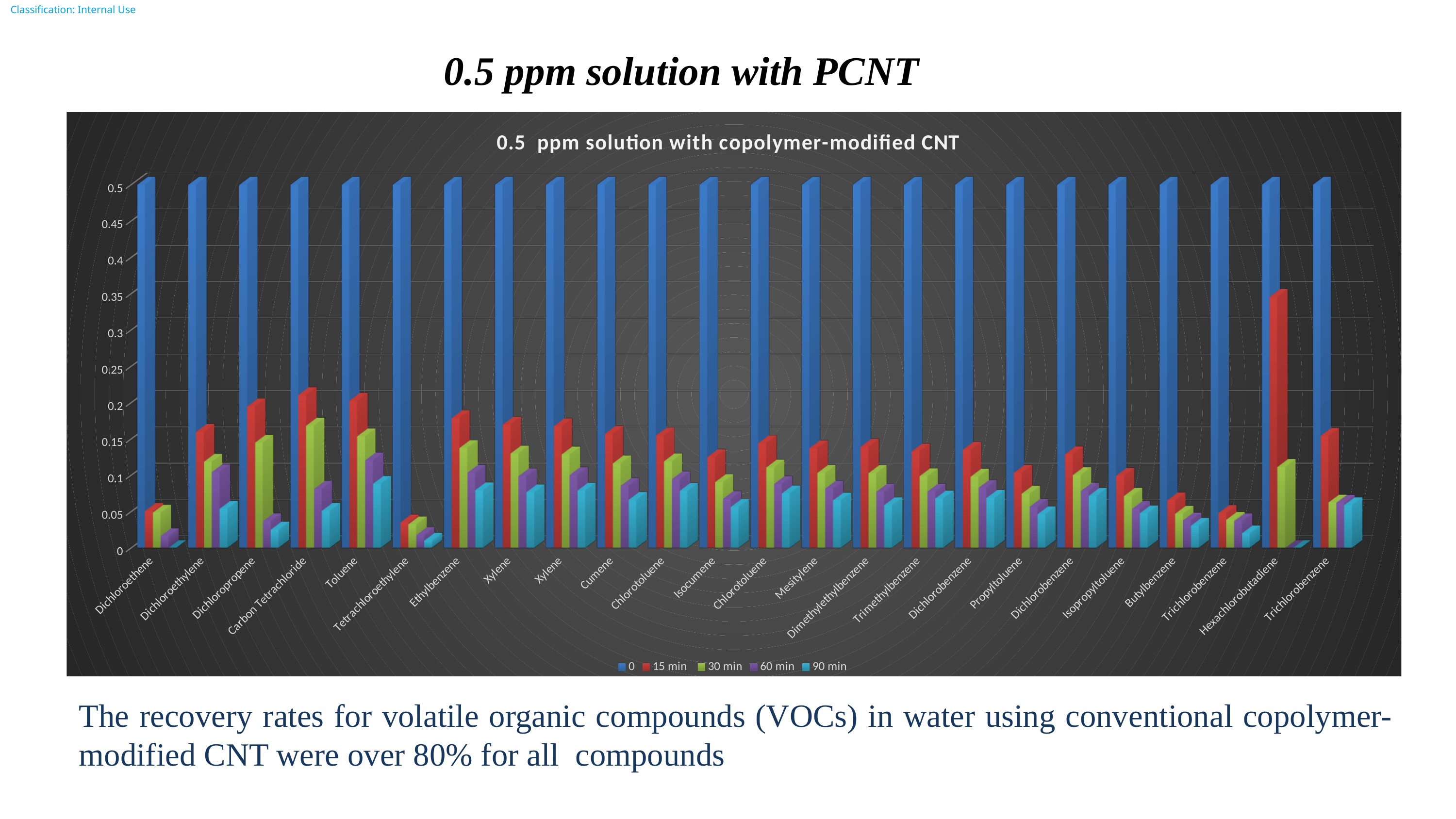
How many categories are shown along the x axis? 24 Which legend entry is shown in red? 15 min What is the title of the chart? 0.5 ppm solution with copolymer-modified CNT What kind of chart is shown on the slide? bar chart What is the value of the "0" series for Toluene? 0.5 Is the 15 min value for Hexachlorobutadiene greater or less than 0.3? greater Which is larger: the 30 min value for Carbon Tetrachloride or the 30 min value for Dichloroethene? Carbon Tetrachloride Is the 15 min value for Carbon Tetrachloride greater or less than 0.15? greater Which category has the highest value for the 15 min series? Hexachlorobutadiene How many series does the legend list? 5 Is the 15 min value for Tetrachloroethylene greater or less than 0.1? less For Toluene, do the values rise or fall going from the 0 series to the 90 min series? fall